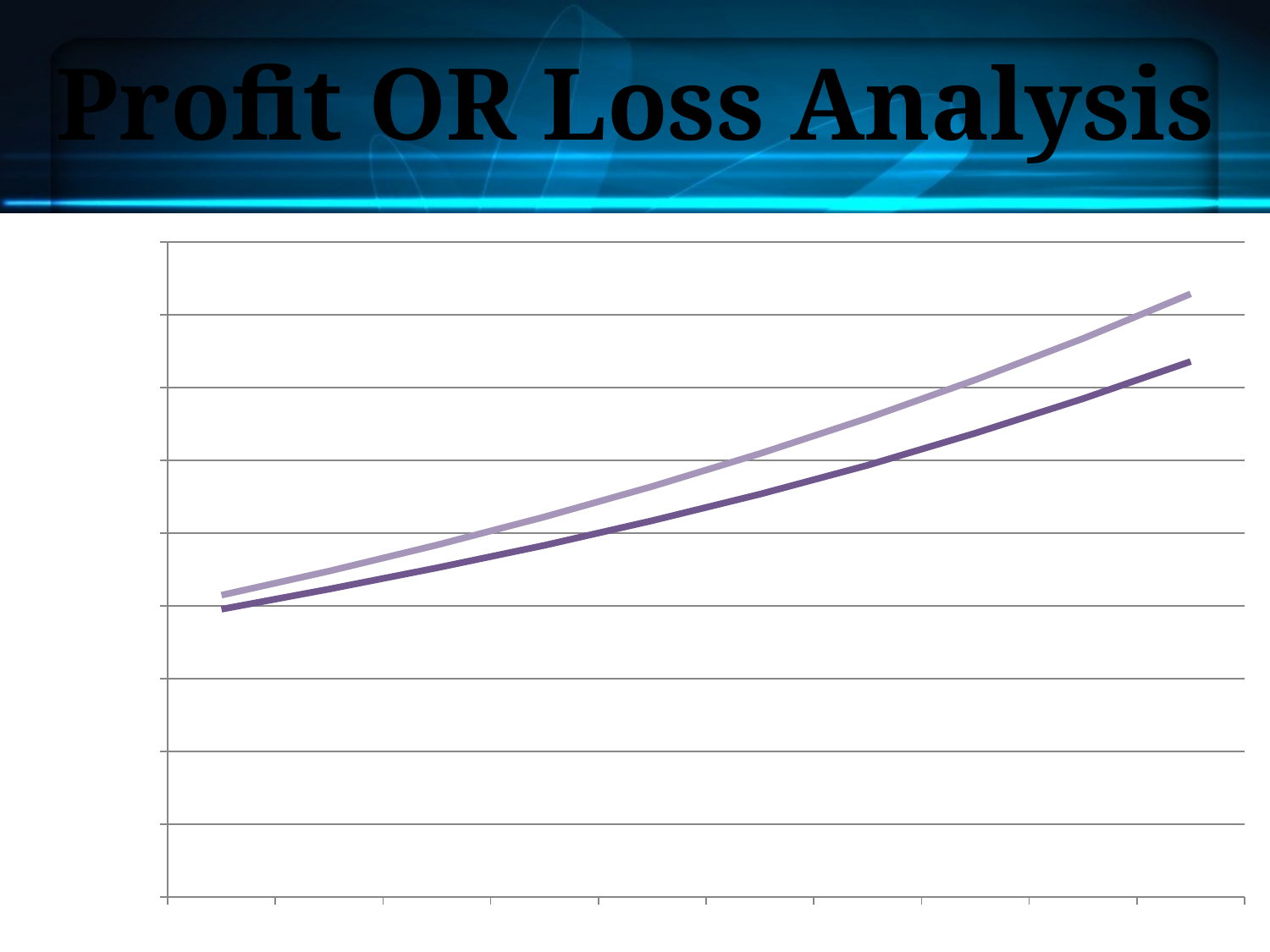
Does the gap between the two lines widen or narrow as they move to the right? Widen How many lines are plotted on the chart? 2 Which line is higher across the chart, the lighter purple line or the darker purple line? The lighter purple line What is the title shown above the chart? Profit OR Loss Analysis Do the plotted lines rise or fall from left to right? Rise What kind of chart is shown on the slide? Line chart